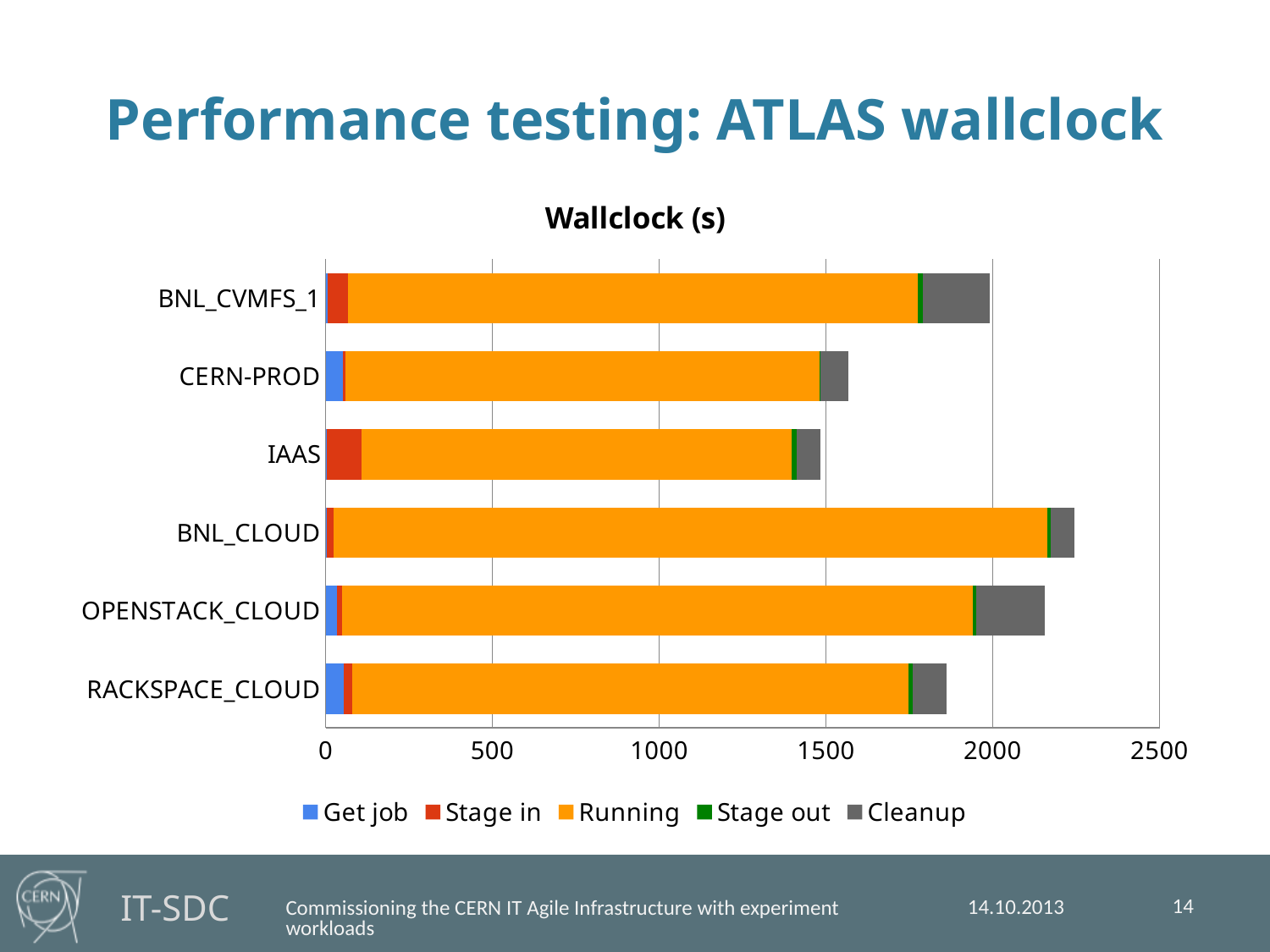
Which site has the shortest total wallclock bar? IAAS What kind of chart is shown on the slide? bar chart Which has the larger total wallclock, BNL_CLOUD or CERN-PROD? BNL_CLOUD Is the total wallclock for RACKSPACE_CLOUD greater or less than 2000? less Which site has the longest total wallclock bar? BNL_CLOUD Which series makes up the largest part of every bar? Running How many series does the legend list? 5 Which site has the larger Stage in segment, IAAS or BNL_CLOUD? IAAS Is the total wallclock for BNL_CLOUD greater or less than 2000? greater What is the title of the chart? Wallclock (s) How many categories (sites) are plotted on the chart? 6